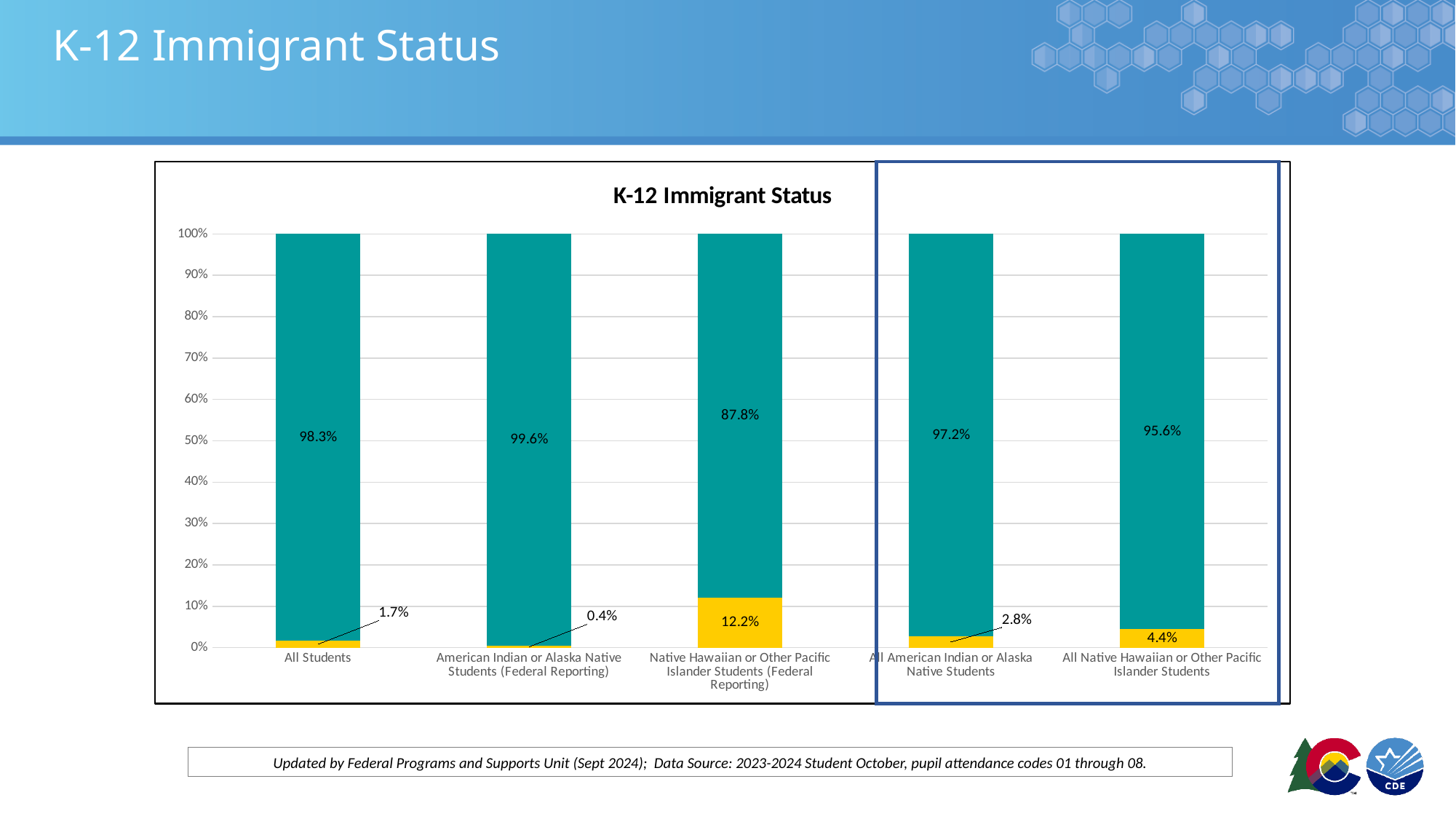
What kind of chart is shown on the slide? Stacked bar chart What is the value of the yellow segment for All Native Hawaiian or Other Pacific Islander Students? 4.4% What is the title of the chart? K-12 Immigrant Status What is the total of the stacked bar for All American Indian or Alaska Native Students? 100% How many categories are shown on the x axis of the chart? 5 What is the value of the teal segment for Native Hawaiian or Other Pacific Islander Students (Federal Reporting)? 87.8% Which is larger: the yellow segment for All Students or the yellow segment for All American Indian or Alaska Native Students? All American Indian or Alaska Native Students What is the difference between the yellow segment values for All American Indian or Alaska Native Students and American Indian or Alaska Native Students (Federal Reporting)? 2.4% What is the value of the yellow segment for All Students? 1.7% Is the teal segment value for All Native Hawaiian or Other Pacific Islander Students greater or less than 90%? greater Which category has the largest yellow segment? Native Hawaiian or Other Pacific Islander Students (Federal Reporting) Which category has the smallest yellow segment? American Indian or Alaska Native Students (Federal Reporting)